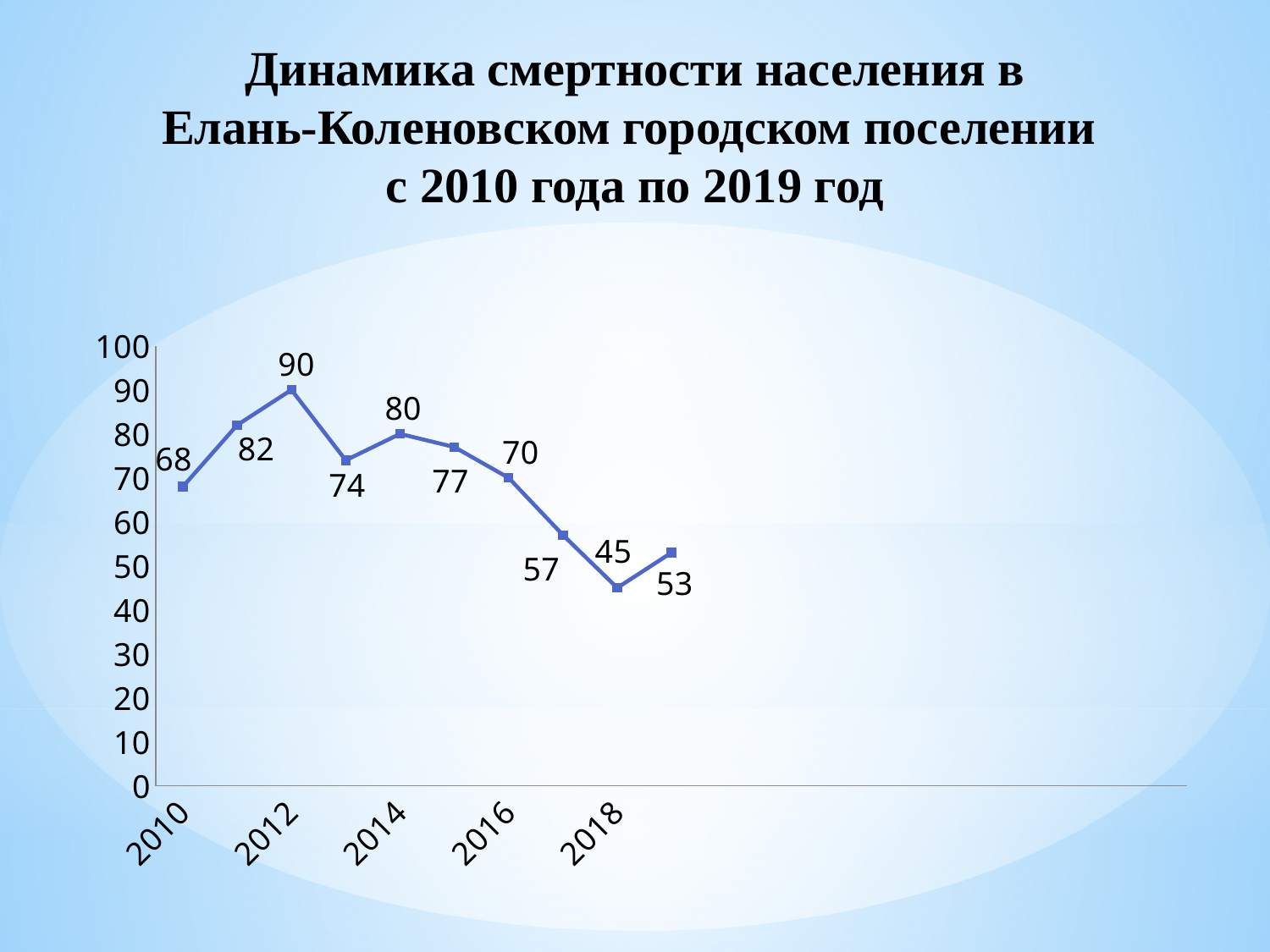
Do the values generally rise or fall from 2012 to 2018? fall How many data points are plotted on the line? 10 What type of chart is shown on the slide? line chart What is the value for 2018? 45 What is the difference between the values for 2012 and 2018? 45 What is the value for 2010? 68 What is the value for 2016? 70 Which year has the lowest value? 2018 What is the value for 2014? 80 Which is larger, the value for 2014 or the value for 2016? 2014 Which year has the highest value? 2012 What is the value for 2012? 90